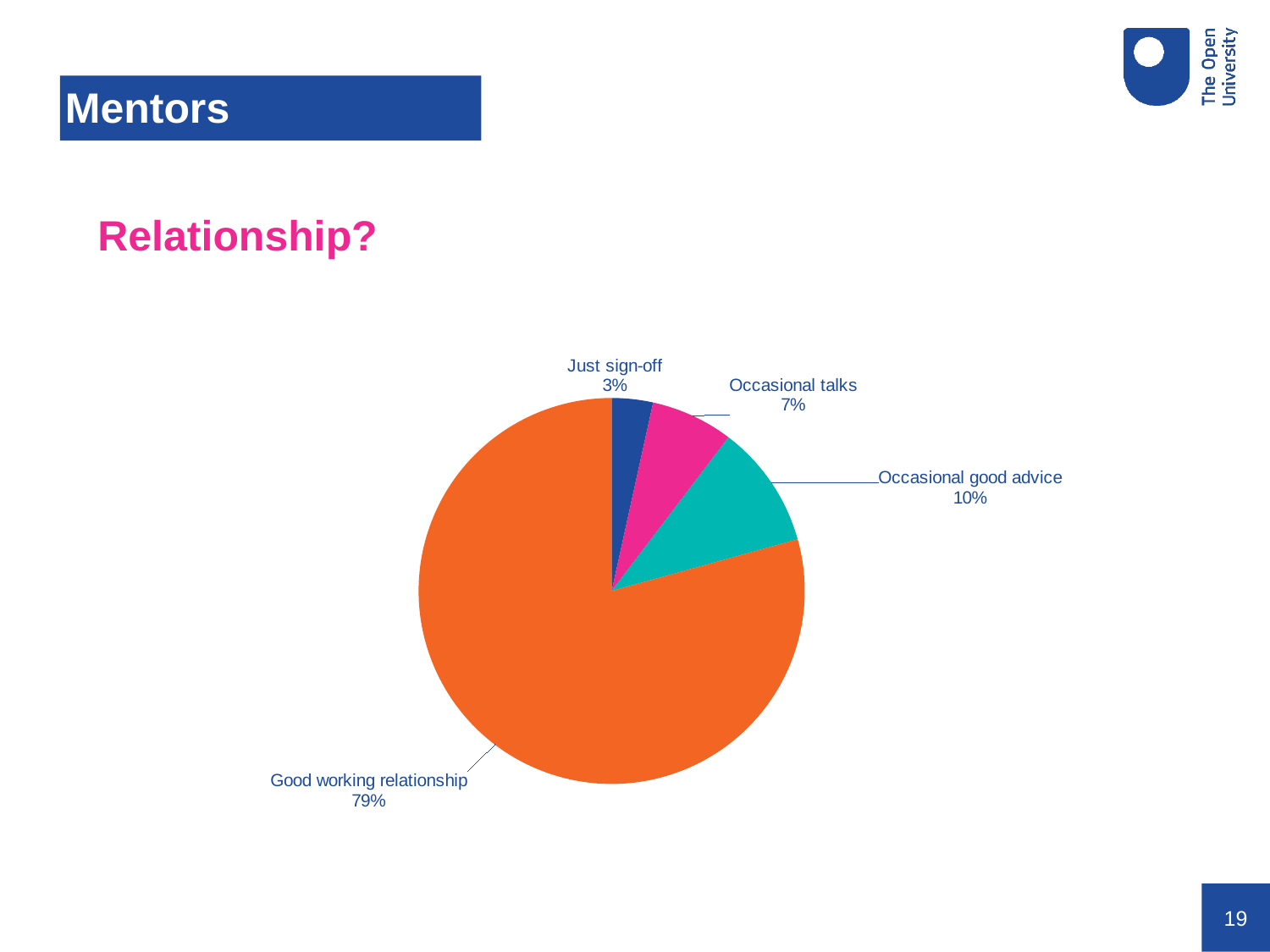
What is the difference in percentage points between 'Occasional good advice' and 'Occasional talks'? 3 What share of the pie is 'Just sign-off'? 3% Which is larger, 'Occasional talks' or 'Just sign-off'? Occasional talks What colour is the 'Good working relationship' slice? orange What share of the pie is 'Occasional good advice'? 10% What share of the pie is 'Good working relationship'? 79% What kind of chart is shown on the slide? pie chart How many slices does the pie chart have? 4 What is the difference in percentage points between 'Good working relationship' and 'Occasional good advice'? 69 Which category has the largest slice of the pie? Good working relationship Which category has the smallest slice of the pie? Just sign-off